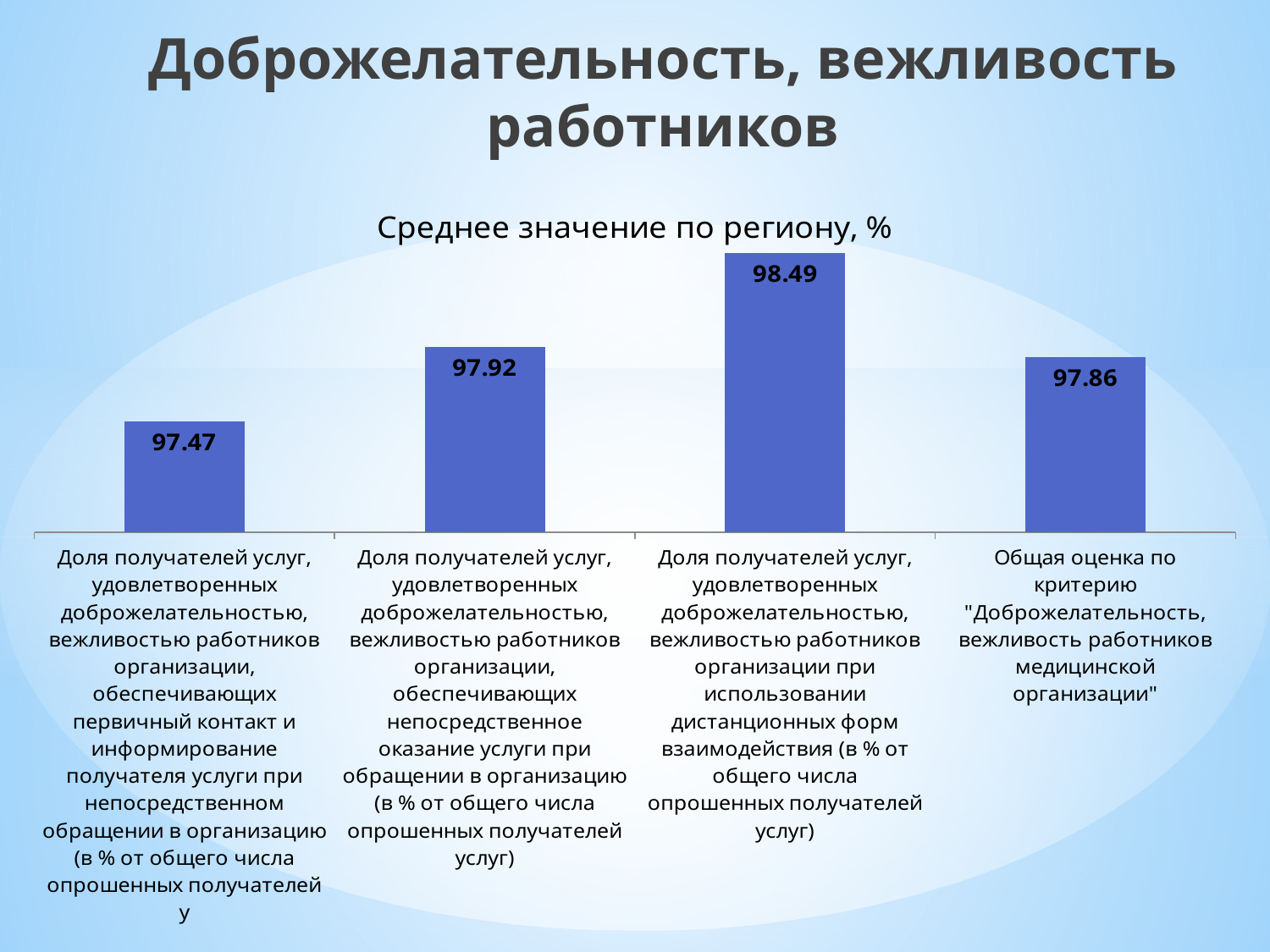
Какое значение показано для категории «Общая оценка по критерию "Доброжелательность, вежливость работников медицинской организации"»? 97.86 Какое значение показано для доли получателей услуг, удовлетворенных доброжелательностью работников, обеспечивающих непосредственное оказание услуги? 97.92 Как называется диаграмма на слайде? Среднее значение по региону, % Сколько категорий (столбцов) показано на диаграмме? 4 Какая категория имеет наименьшее значение на диаграмме? Доля получателей услуг, удовлетворенных доброжелательностью, вежливостью работников организации, обеспечивающих первичный контакт и информирование Какая категория имеет наибольшее значение на диаграмме? Доля получателей услуг, удовлетворенных доброжелательностью, вежливостью работников организации при использовании дистанционных форм взаимодействия Какое значение показано для доли получателей услуг, удовлетворенных доброжелательностью работников при использовании дистанционных форм взаимодействия? 98.49 Какого типа эта диаграмма? Столбчатая (bar chart) На сколько значение для дистанционных форм взаимодействия (98.49) больше значения для первичного контакта и информирования (97.47)? 1.02 На сколько значение для непосредственного оказания услуги (97.92) больше общей оценки по критерию (97.86)? 0.06 Что больше: значение для непосредственного оказания услуги или значение для первичного контакта и информирования? Значение для непосредственного оказания услуги (97.92) Какое значение показано для доли получателей услуг, удовлетворенных доброжелательностью работников, обеспечивающих первичный контакт и информирование? 97.47